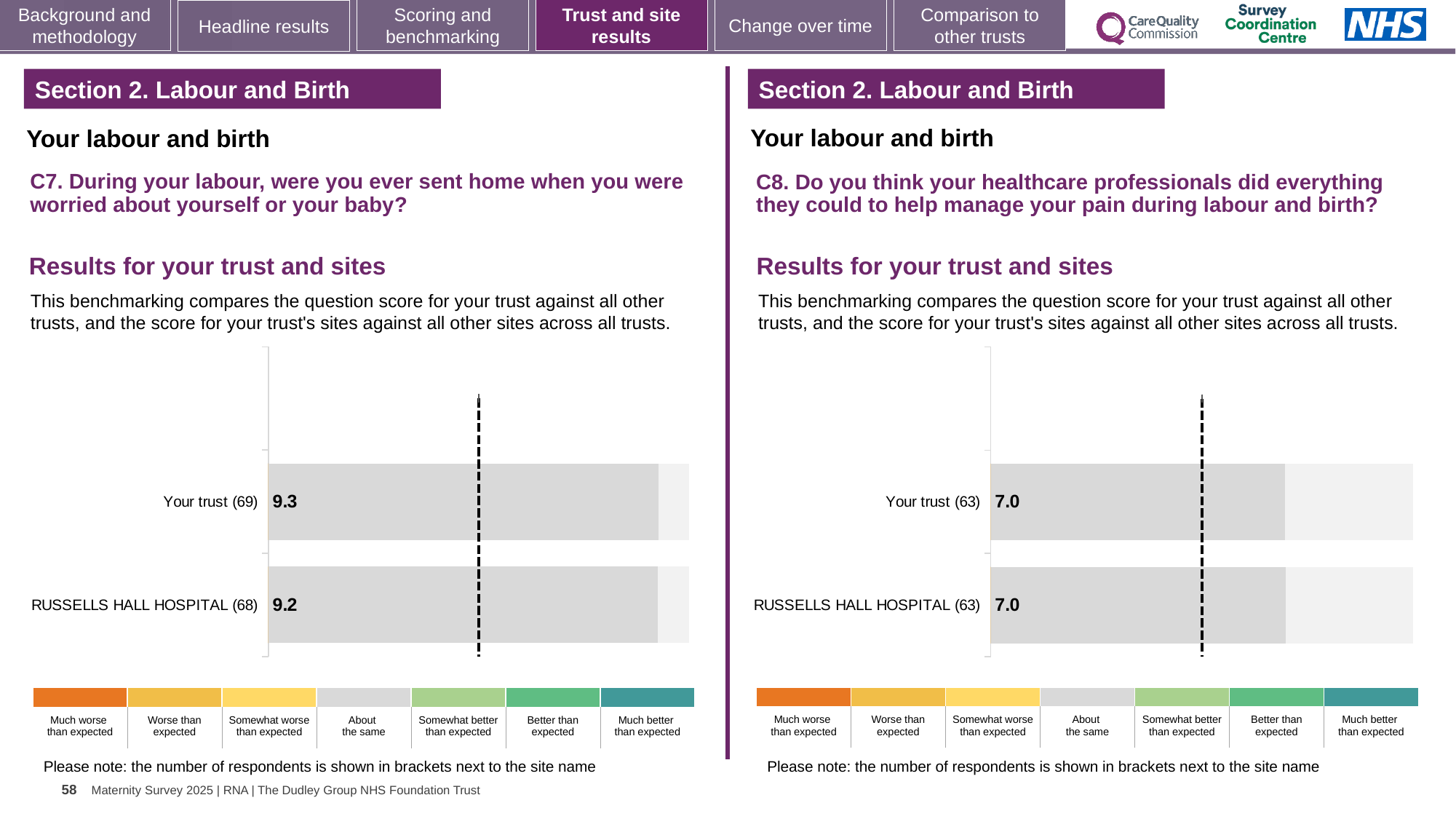
In the C7 chart on the left, what is the score for RUSSELLS HALL HOSPITAL? 9.2 In the C8 chart on the right, is the score for Your trust higher than, lower than, or equal to the score for RUSSELLS HALL HOSPITAL? Equal In the C7 chart on the left, how many respondents are shown in brackets for Your trust? 69 In the C8 chart on the right, how many respondents are shown in brackets for RUSSELLS HALL HOSPITAL? 63 In the C8 chart on the right, what is the score for Your trust? 7.0 In the C7 chart on the left, what is the difference between the score for Your trust and the score for RUSSELLS HALL HOSPITAL? 0.1 In the C8 chart on the right, what is the score for RUSSELLS HALL HOSPITAL? 7.0 How many bars are plotted in the C7 chart on the left? 2 In the C7 chart on the left, what is the score for Your trust? 9.3 In the C7 chart on the left, which category has the lowest score? RUSSELLS HALL HOSPITAL In the C7 chart on the left, which has the higher score, Your trust or RUSSELLS HALL HOSPITAL? Your trust What kind of chart is used in the C8 chart on the right? Bar chart